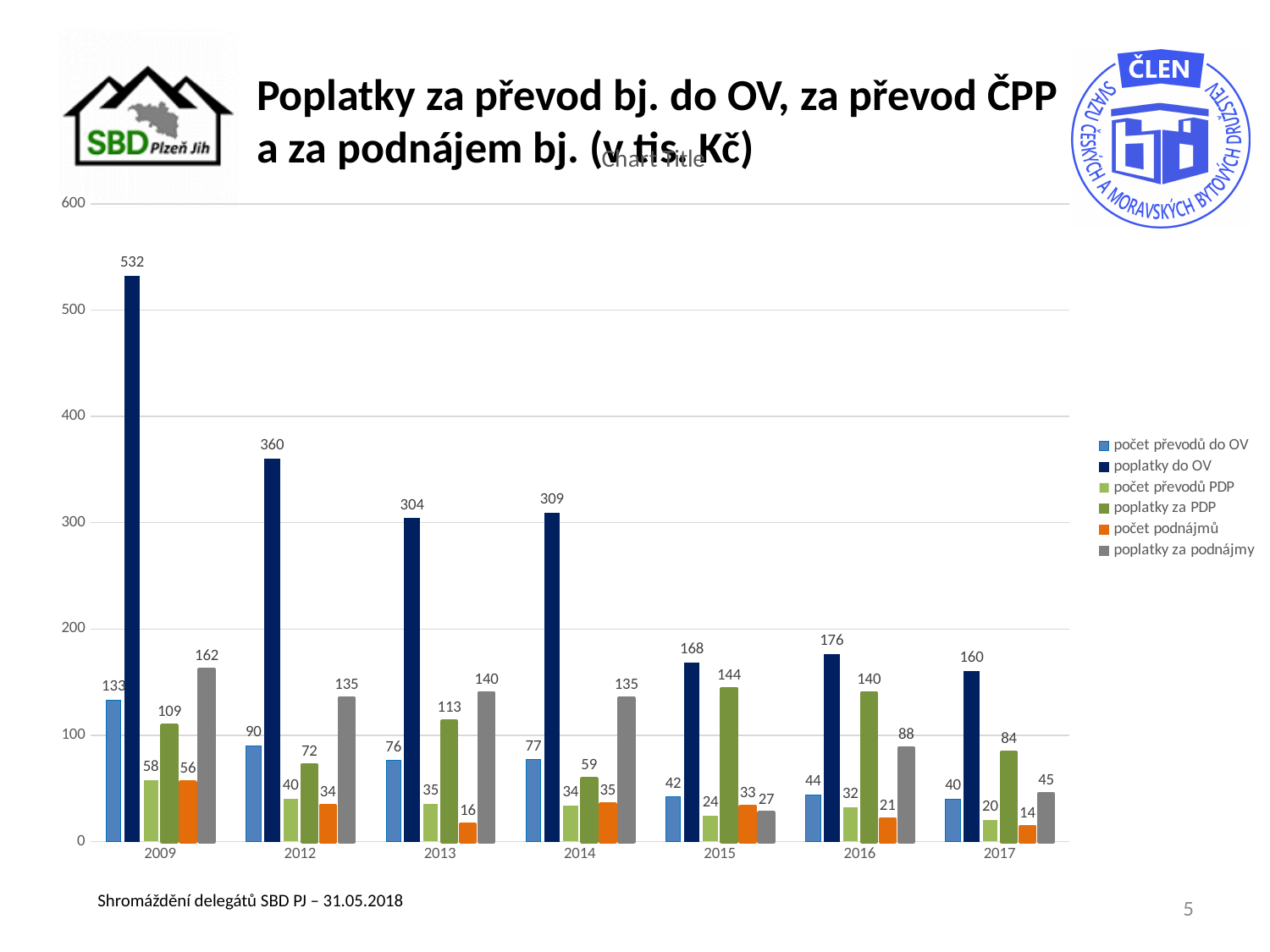
What is the value of počet podnájmů in 2013? 16 What type of chart is shown on the slide? bar chart How many years are shown on the x axis? 7 In which year is poplatky za podnájmy the lowest? 2015 Does počet převodů do OV rise or fall from 2009 to 2017 overall? fall What is the value of poplatky za PDP in 2015? 144 What colour are the bars for poplatky za podnájmy? gray In which year is poplatky do OV the highest? 2009 What is the value of poplatky do OV in 2009? 532 What is the difference between poplatky do OV in 2012 and in 2013? 56 Which is larger: poplatky za PDP in 2016 or poplatky za podnájmy in 2016? poplatky za PDP How many series does the legend list? 6